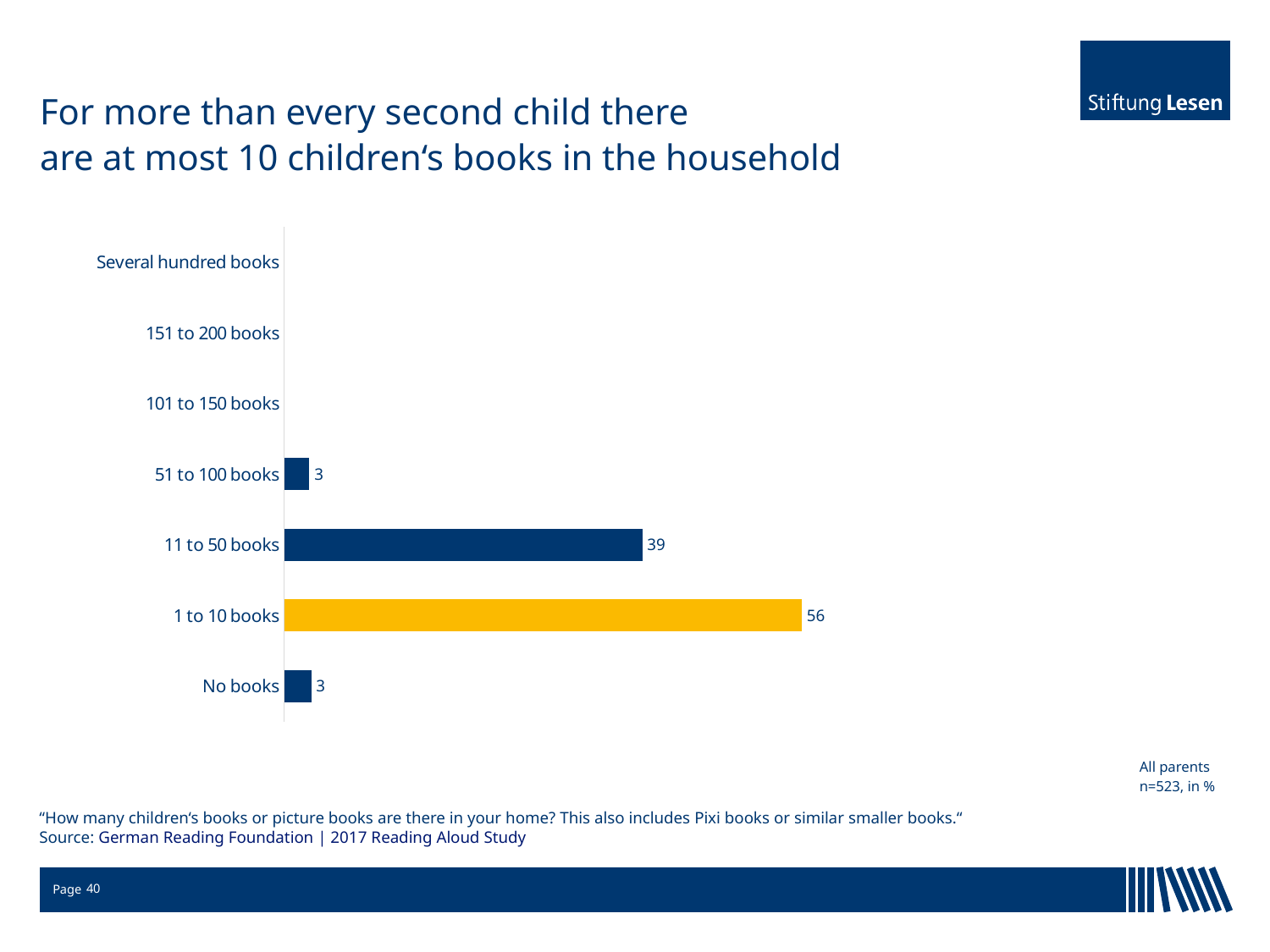
What is the value for "No books"? 3 How many categories are listed on the chart's axis? 7 What kind of chart is shown on the slide? Bar chart What is the difference between the values for "1 to 10 books" and "11 to 50 books"? 17 Which is larger, the value for "11 to 50 books" or the value for "51 to 100 books"? 11 to 50 books What is the value for "1 to 10 books"? 56 What is the value for "11 to 50 books"? 39 What is the sample size (n) stated on the slide? n=523 Which category has the highest value? 1 to 10 books Which category's bar is shown in yellow rather than dark blue? 1 to 10 books What is the difference between the values for "11 to 50 books" and "No books"? 36 What is the value for "51 to 100 books"? 3